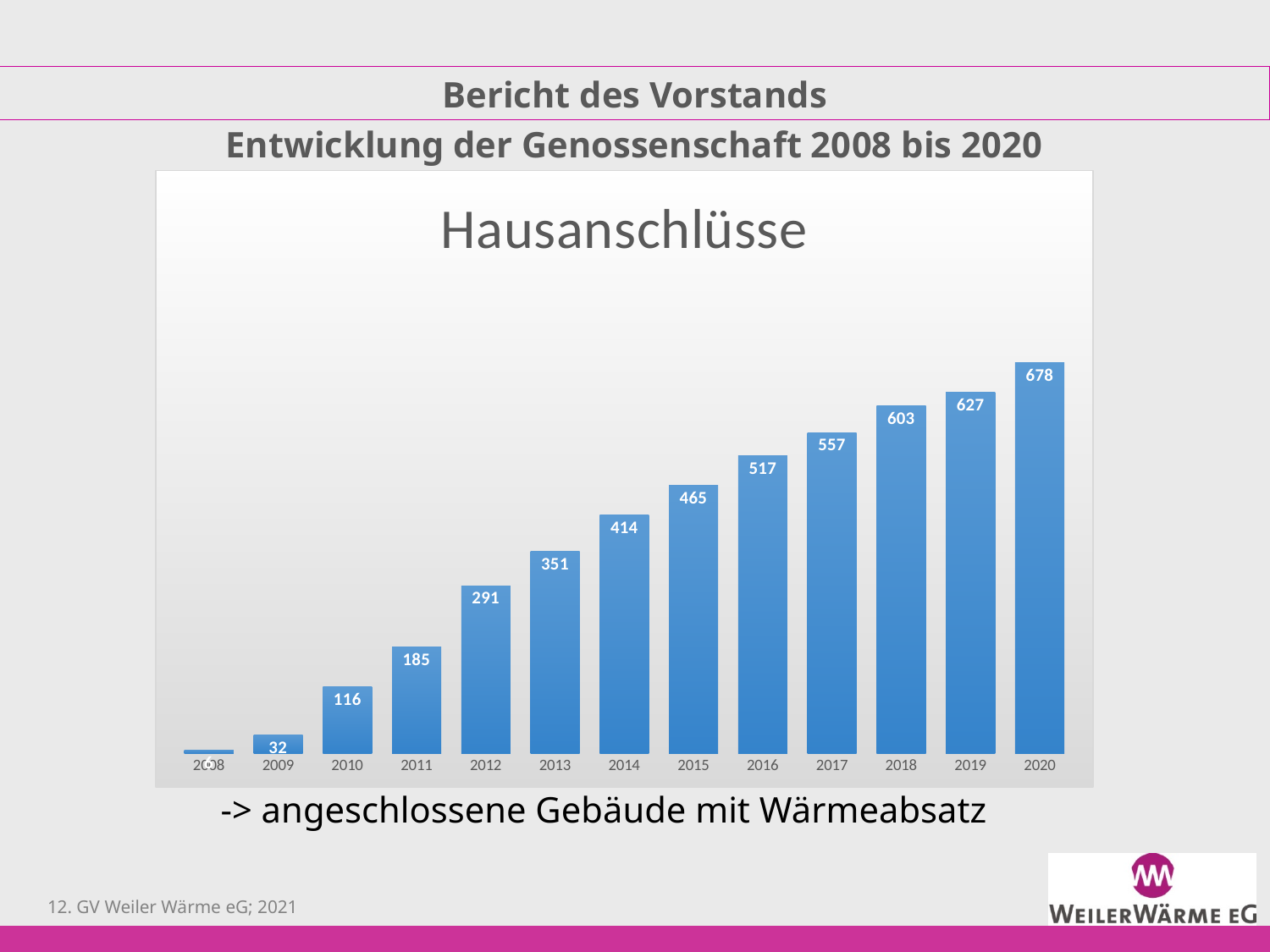
What is the value for 2020 in the Hausanschlüsse chart? 678 What is the title of the chart on the slide? Hausanschlüsse What is the difference between the values for 2020 and 2019 in the Hausanschlüsse chart? 51 Which year has the lowest value in the Hausanschlüsse chart? 2008 Which is larger in the Hausanschlüsse chart, the value for 2012 or the value for 2014? 2014 What is the difference between the values for 2016 and 2015 in the Hausanschlüsse chart? 52 What kind of chart is the Hausanschlüsse chart? bar chart Do the values in the Hausanschlüsse chart rise or fall from 2008 to 2020? rise What is the value for 2013 in the Hausanschlüsse chart? 351 What is the value for 2009 in the Hausanschlüsse chart? 32 Which year has the highest value in the Hausanschlüsse chart? 2020 How many years are shown on the x axis of the Hausanschlüsse chart? 13